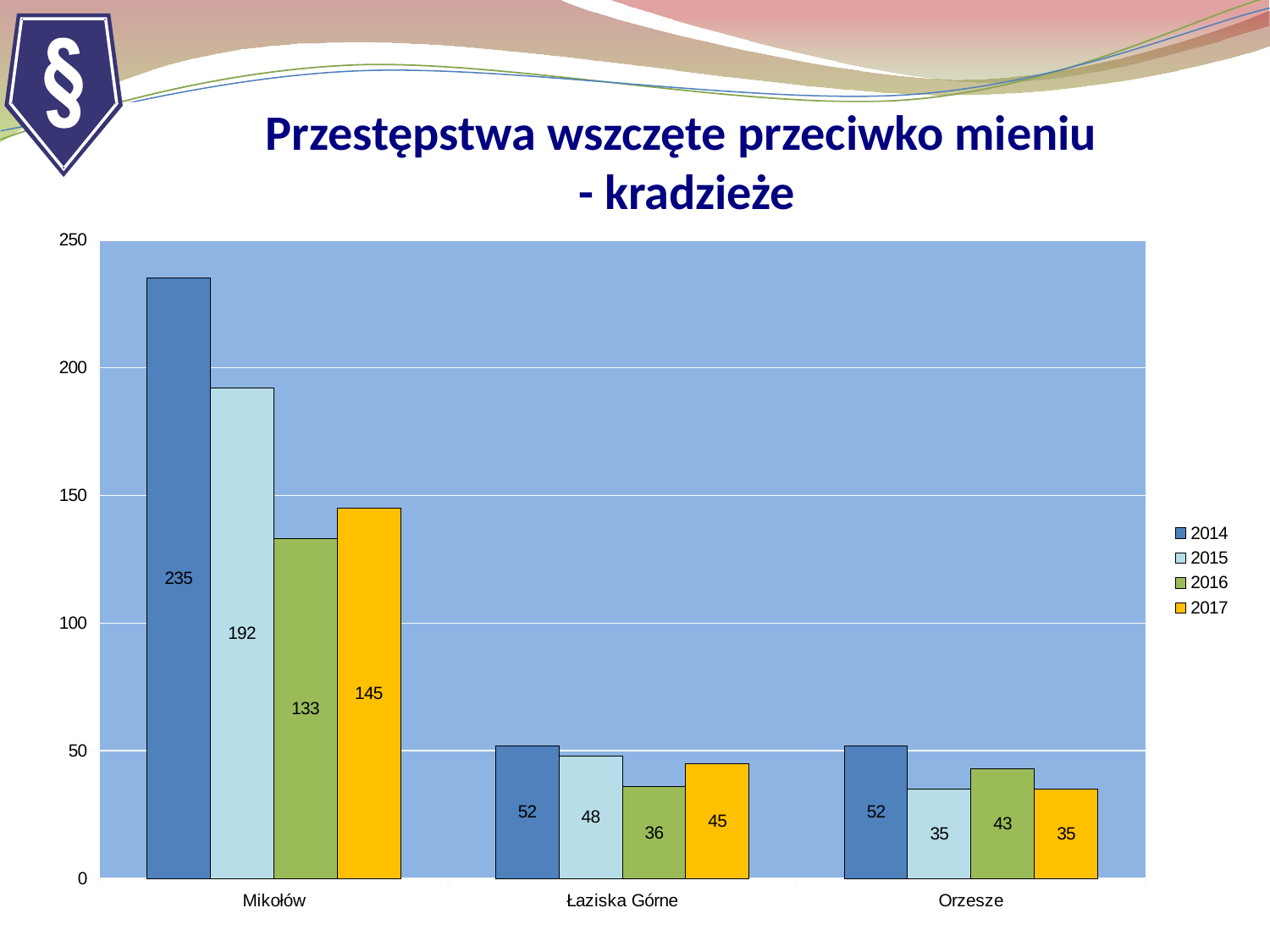
Which category has the highest value in 2015? Mikołów What is the difference between the 2014 and 2017 values for Mikołów? 90 What is the value for Mikołów in 2014? 235 What is the value for Łaziska Górne in 2016? 36 How many series does the legend list? 4 What is the value for Orzesze in 2017? 35 Which is larger for Orzesze: the 2016 value or the 2015 value? 2016 Which year has the lowest value for Mikołów? 2016 What kind of chart is shown on the slide? bar chart What is the title of the chart on the slide? Przestępstwa wszczęte przeciwko mieniu - kradzieże Is the value for Mikołów in 2015 greater or less than 150? greater How many categories are shown on the x axis? 3